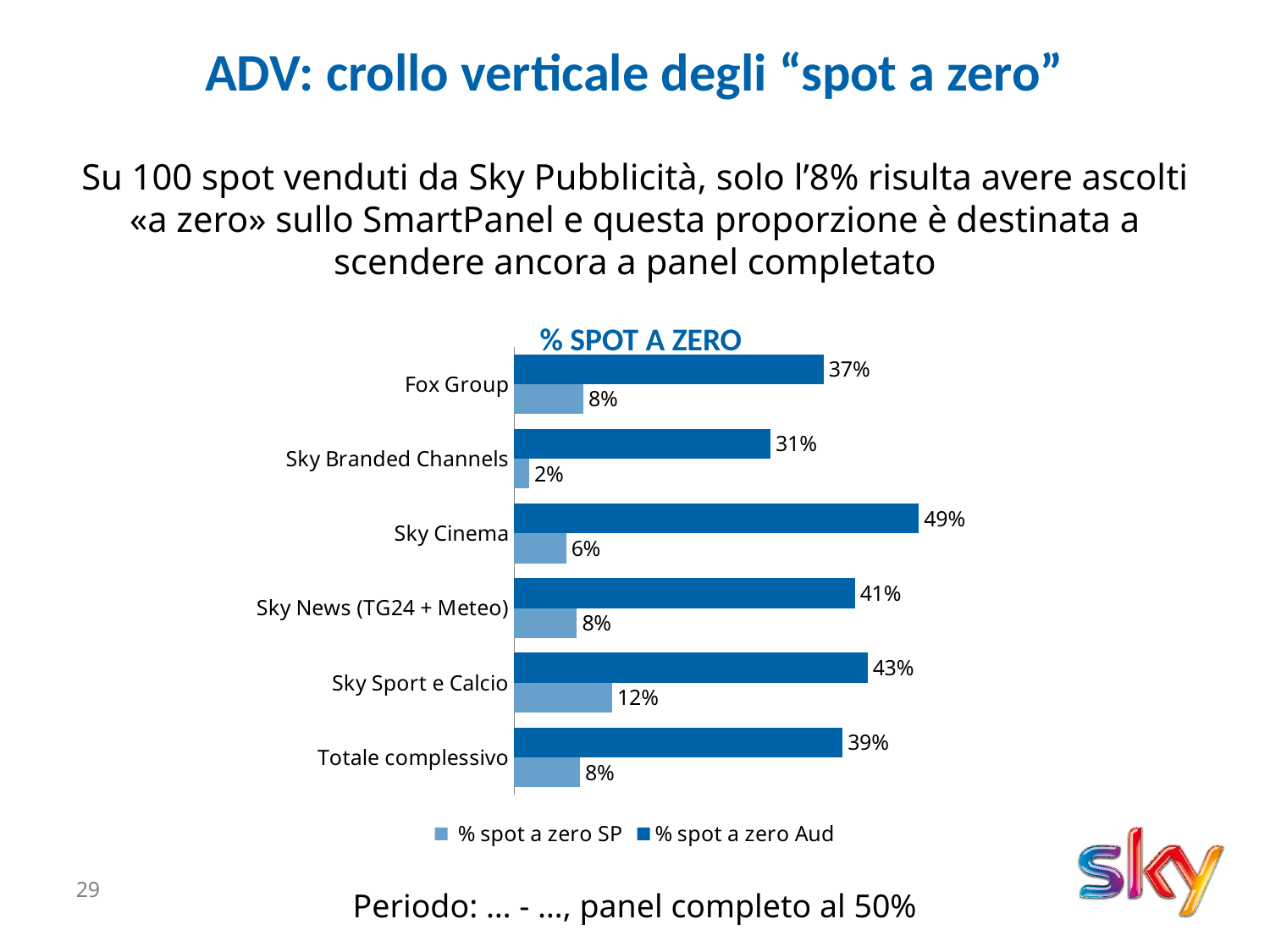
What is the difference between the "% spot a zero Aud" and "% spot a zero SP" values for Totale complessivo? 31% What is the value of "% spot a zero Aud" for Sky News (TG24 + Meteo)? 41% Which is larger for Fox Group: "% spot a zero SP" or "% spot a zero Aud"? % spot a zero Aud Which category has the lowest "% spot a zero SP" value? Sky Branded Channels What is the value of "% spot a zero Aud" for Sky Cinema? 49% How many categories are shown in the chart? 6 What is the title of the chart? % SPOT A ZERO What kind of chart is shown on the slide? Bar chart How many series does the legend list? 2 What is the value of "% spot a zero SP" for Sky Sport e Calcio? 12% Which category has the highest "% spot a zero Aud" value? Sky Cinema What is the value of "% spot a zero SP" for Sky Branded Channels? 2%